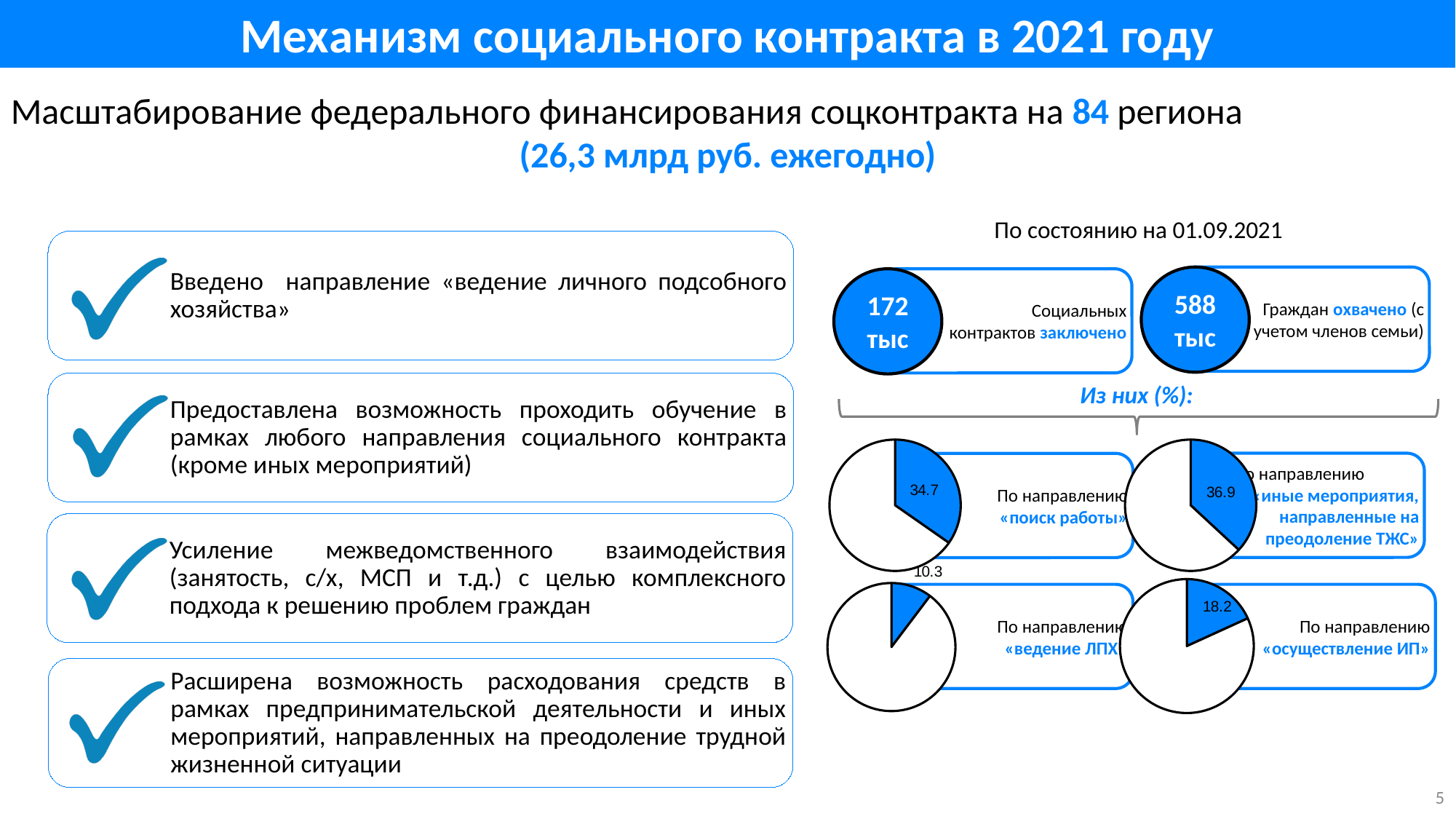
In the pie chart for the direction «поиск работы», what value is printed on the highlighted slice? 34.7 In the pie chart for the direction «ведение ЛПХ», what value is printed for the highlighted slice? 10.3 What is the difference between the highlighted share for «иные мероприятия, направленные на преодоление ТЖС» and the highlighted share for «поиск работы»? 2.2 Which highlighted share is larger: «осуществление ИП» or «ведение ЛПХ»? «осуществление ИП» What kind of charts are used to show the shares by direction on the right side of the slide? Pie charts Across the four pie charts, which direction has the smallest highlighted share? «ведение ЛПХ» Across the four pie charts, which direction has the largest highlighted share? «иные мероприятия, направленные на преодоление ТЖС» What is the difference between the highlighted shares for «осуществление ИП» and «ведение ЛПХ»? 7.9 In the pie chart for the direction «иные мероприятия, направленные на преодоление ТЖС», what value is printed on the highlighted slice? 36.9 In the pie chart for the direction «осуществление ИП», what value is printed on the highlighted slice? 18.2 What colour is used for the highlighted slice in each of the four pie charts? Blue How many pie charts are shown on the slide? 4